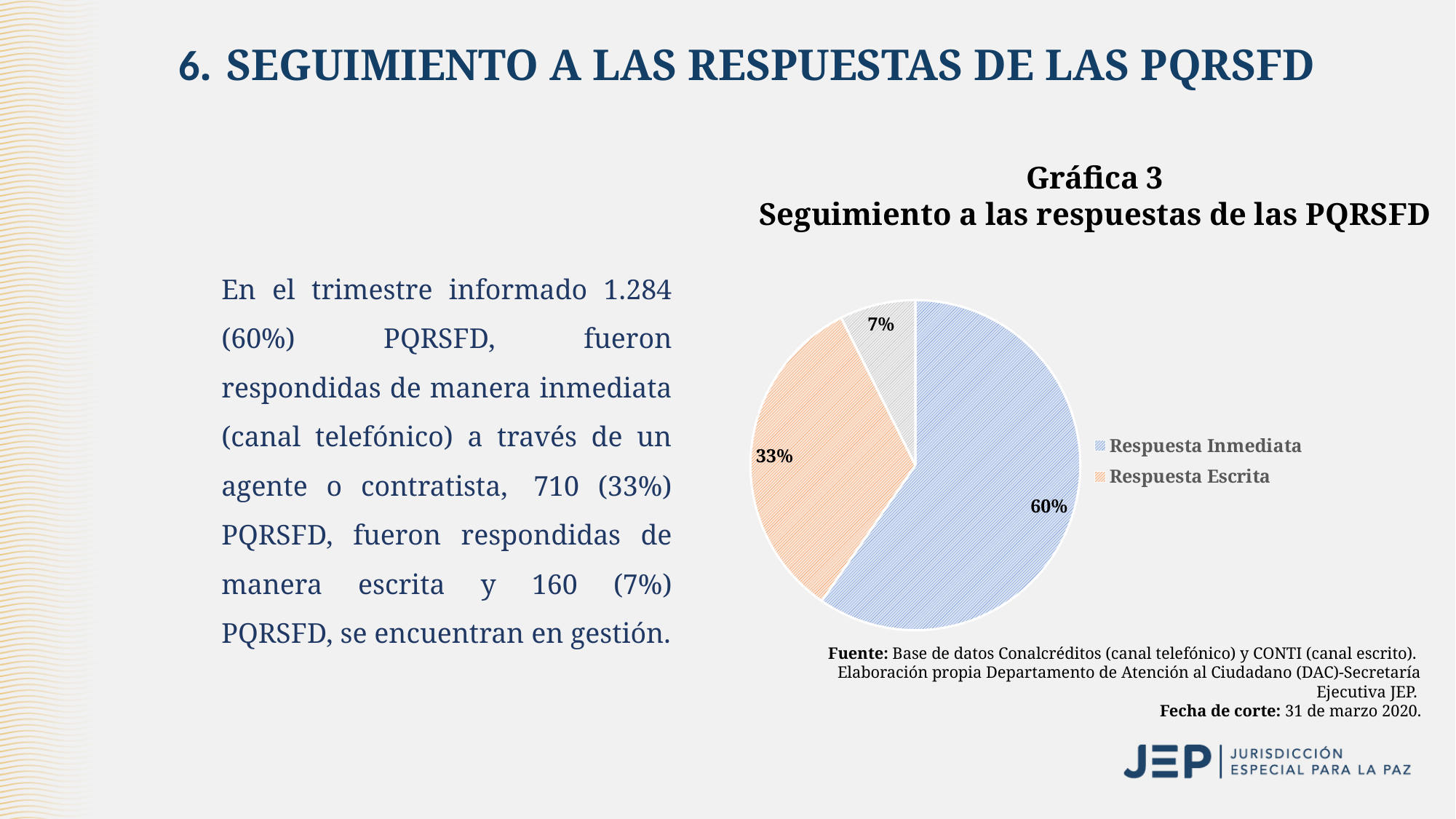
What is the title of the chart? Gráfica 3 Seguimiento a las respuestas de las PQRSFD What kind of chart is shown on the slide? Pie chart How many slices does the pie chart have? 3 Which is larger, the slice for Respuesta Inmediata or the slice for Respuesta Escrita? Respuesta Inmediata What colour is the slice for Respuesta Escrita? Orange What share of the pie does Respuesta Inmediata represent? 60% What share of the pie does Respuesta Escrita represent? 33% Which category has the largest slice of the pie? Respuesta Inmediata What is the difference in percentage points between the Respuesta Inmediata slice and the Respuesta Escrita slice? 27 How many entries does the legend list? 2 What percentage is shown on the smallest slice of the pie? 7% Is the share for Respuesta Inmediata greater or less than 50%? greater